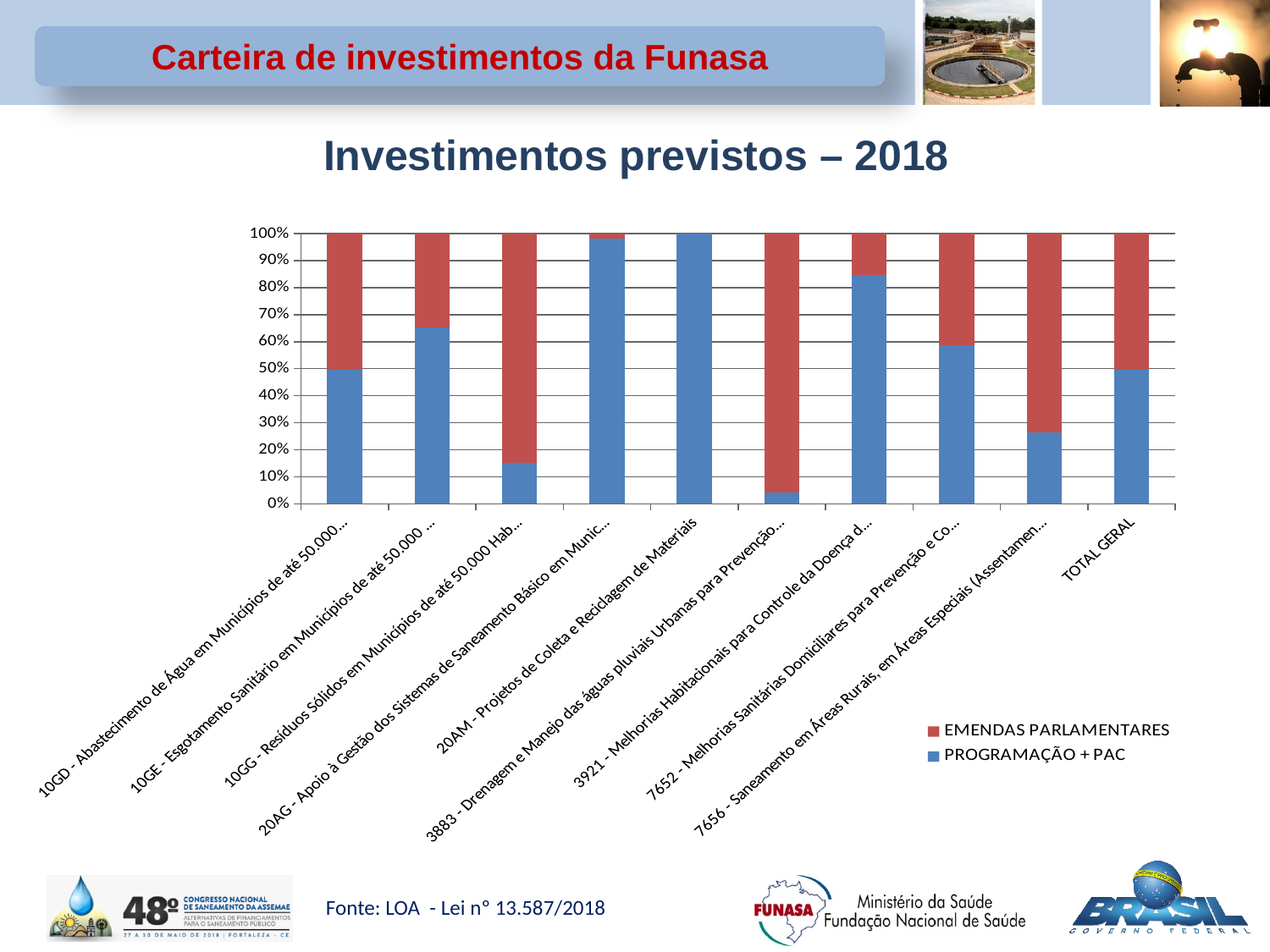
Is the PROGRAMAÇÃO + PAC share for 3921 - Melhorias Habitacionais greater or less than 80%? greater Which category has the highest share of EMENDAS PARLAMENTARES? 3883 - Drenagem e Manejo das águas pluviais Urbanas para Prevenção... Which category has the lowest share of PROGRAMAÇÃO + PAC? 3883 - Drenagem e Manejo das águas pluviais Urbanas para Prevenção... Is the PROGRAMAÇÃO + PAC share for 10GG - Resíduos Sólidos greater or less than 20%? less Which has a larger EMENDAS PARLAMENTARES share: 7656 - Saneamento em Áreas Rurais or 7652 - Melhorias Sanitárias Domiciliares? 7656 - Saneamento em Áreas Rurais How many series does the chart legend list? 2 What is the title of the chart? Investimentos previstos – 2018 Which has a larger PROGRAMAÇÃO + PAC share: 10GE - Esgotamento Sanitário or 10GG - Resíduos Sólidos? 10GE - Esgotamento Sanitário Is the PROGRAMAÇÃO + PAC share for 7656 - Saneamento em Áreas Rurais greater or less than 30%? less Which colour represents EMENDAS PARLAMENTARES in the chart? Red What kind of chart is shown on the slide? Stacked bar chart How many categories (bars) are plotted along the x axis? 10